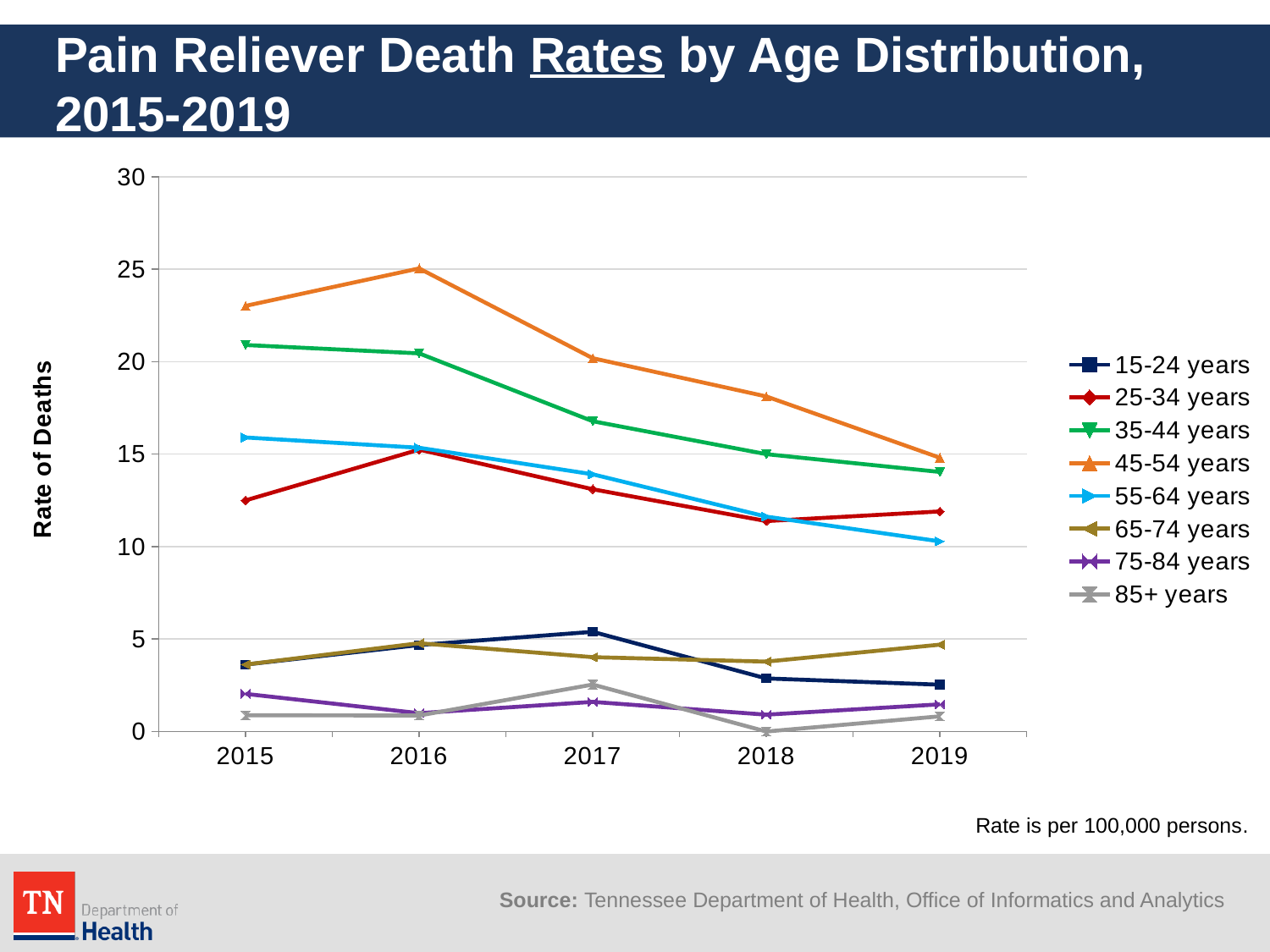
What is the title of the y axis? Rate of Deaths How many years are shown on the x axis? 5 Which age group had the highest pain reliever death rate in 2016? 45-54 years Is the death rate for 45-54 years in 2015 greater or less than 20? greater Is the death rate for 55-64 years in 2019 greater or less than 15? less Which age group had the lowest pain reliever death rate in 2018? 85+ years How many age groups does the legend list? 8 In 2019, which age group had the larger death rate: 25-34 years or 55-64 years? 25-34 years Does the death rate for 45-54 years rise or fall from 2016 to 2019? fall In 2017, which age group had the larger death rate: 35-44 years or 45-54 years? 45-54 years Is the death rate for 15-24 years in 2017 greater or less than 5? greater What kind of chart is shown on the slide? line chart